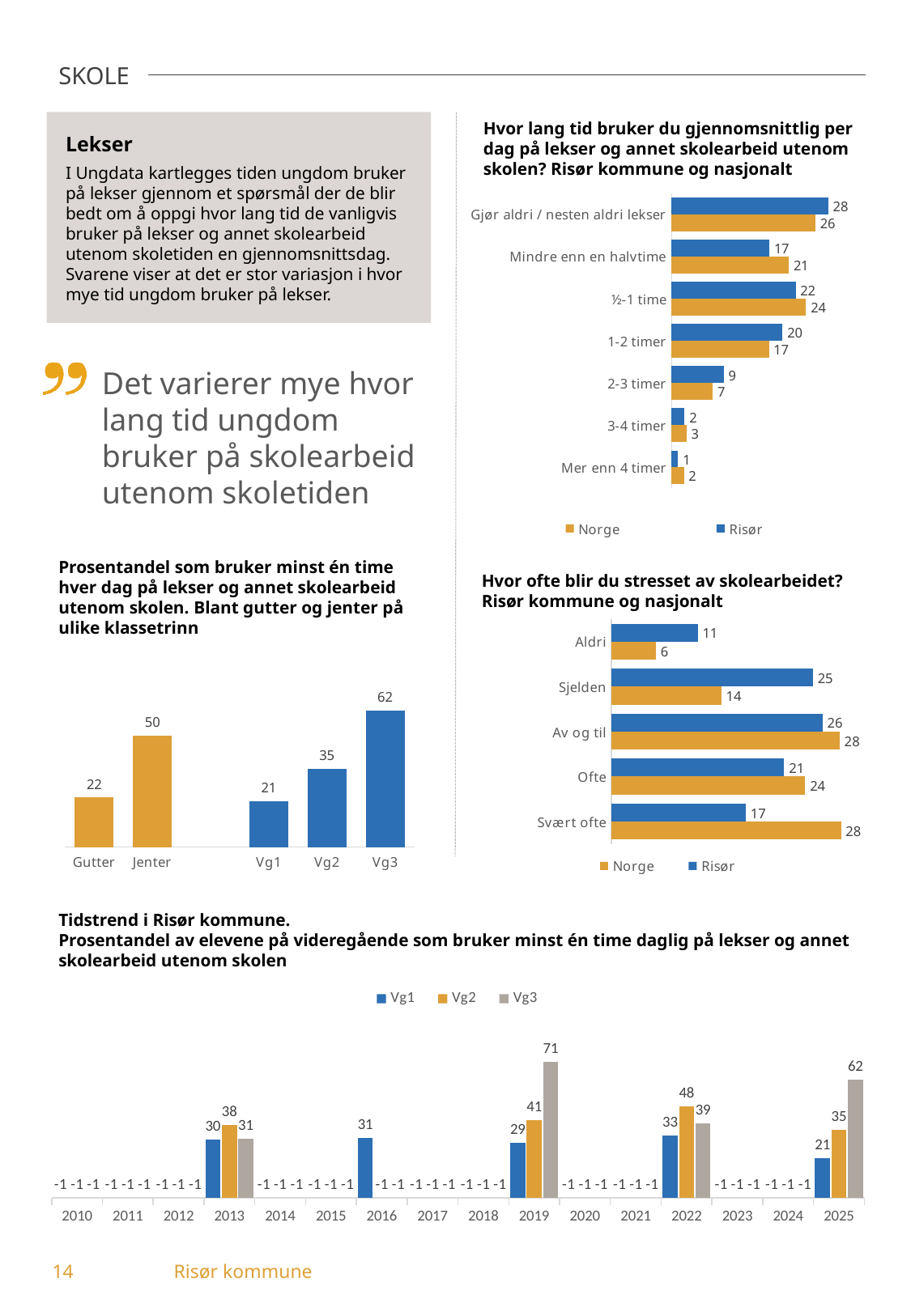
In the chart 'Tidstrend i Risør kommune', what is the value for Vg3 in 2019? 71 In the chart 'Hvor lang tid bruker du gjennomsnittlig per dag på lekser og annet skolearbeid utenom skolen?', what is the value for Norge for '1-2 timer'? 17 What kind of chart is 'Tidstrend i Risør kommune'? Bar chart In the chart 'Hvor ofte blir du stresset av skolearbeidet?', how many series does the legend list? 2 In the chart 'Hvor lang tid bruker du gjennomsnittlig per dag på lekser og annet skolearbeid utenom skolen?', how many categories are shown? 7 In the chart 'Hvor ofte blir du stresset av skolearbeidet?', what is the value for Norge for 'Svært ofte'? 28 In the chart 'Tidstrend i Risør kommune', what is the difference between Vg2 and Vg1 in 2022? 15 In the chart 'Prosentandel som bruker minst én time hver dag på lekser og annet skolearbeid utenom skolen', which category has the highest value? Vg3 In the chart 'Prosentandel som bruker minst én time hver dag på lekser og annet skolearbeid utenom skolen', what is the value for Vg2? 35 In the chart 'Hvor ofte blir du stresset av skolearbeidet?', which is larger for 'Sjelden': Risør or Norge? Risør In the chart 'Prosentandel som bruker minst én time hver dag på lekser og annet skolearbeid utenom skolen', what is the difference between Jenter and Gutter? 28 In the chart 'Hvor lang tid bruker du gjennomsnittlig per dag på lekser og annet skolearbeid utenom skolen?', what is the value for Risør for 'Gjør aldri / nesten aldri lekser'? 28